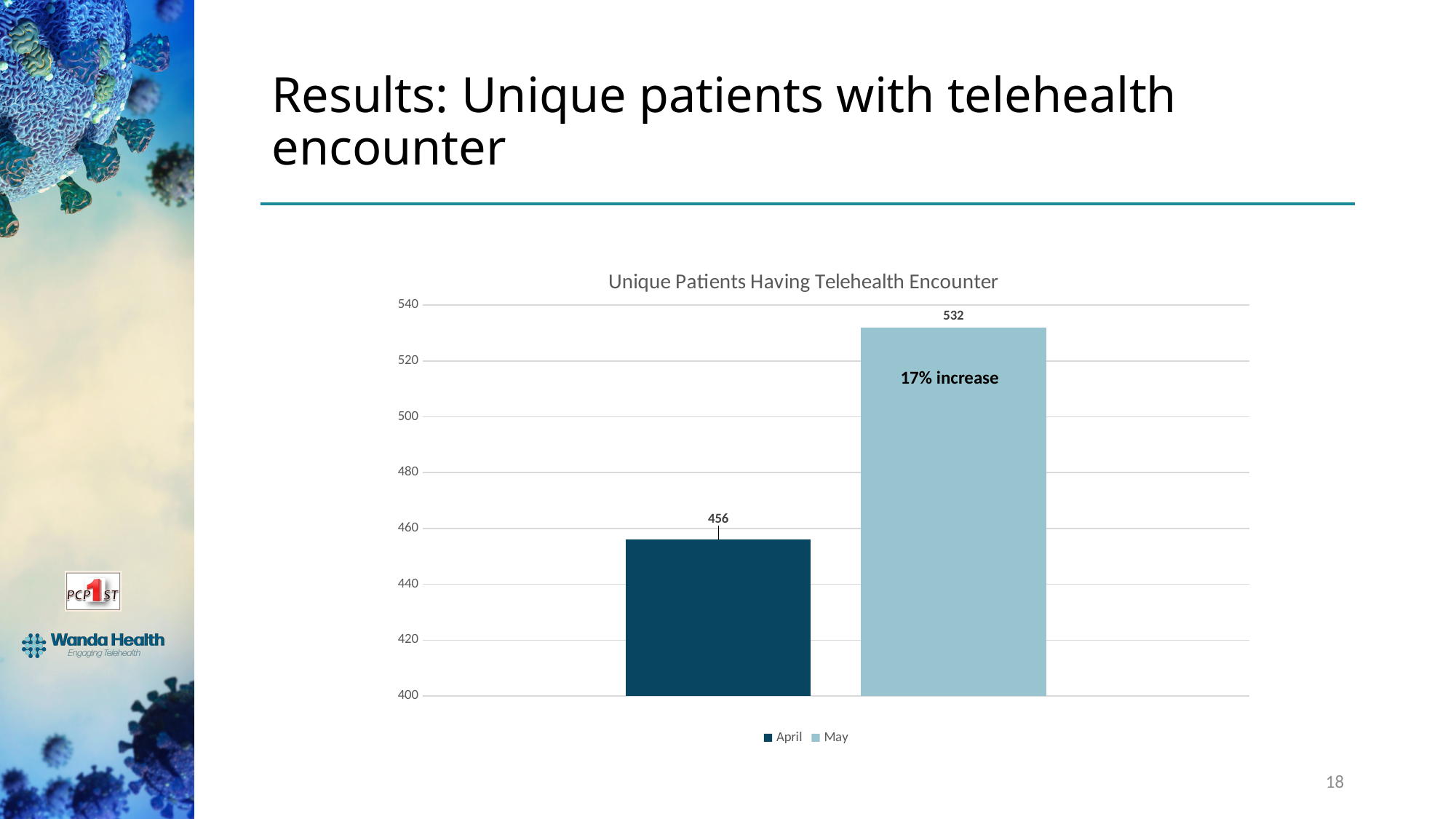
Which month has the lower number of unique patients with a telehealth encounter? April How many series does the legend list? 2 Is the value for May greater or less than 520? greater What is the value for April? 456 What percentage increase is annotated on the May bar? 17% increase What is the title of the chart? Unique Patients Having Telehealth Encounter What kind of chart is shown on the slide? Bar chart Do the values rise or fall from April to May? Rise Which month has the higher number of unique patients with a telehealth encounter? May What is the difference between the May and April values? 76 Is the value for April greater or less than 460? less What is the value for May? 532